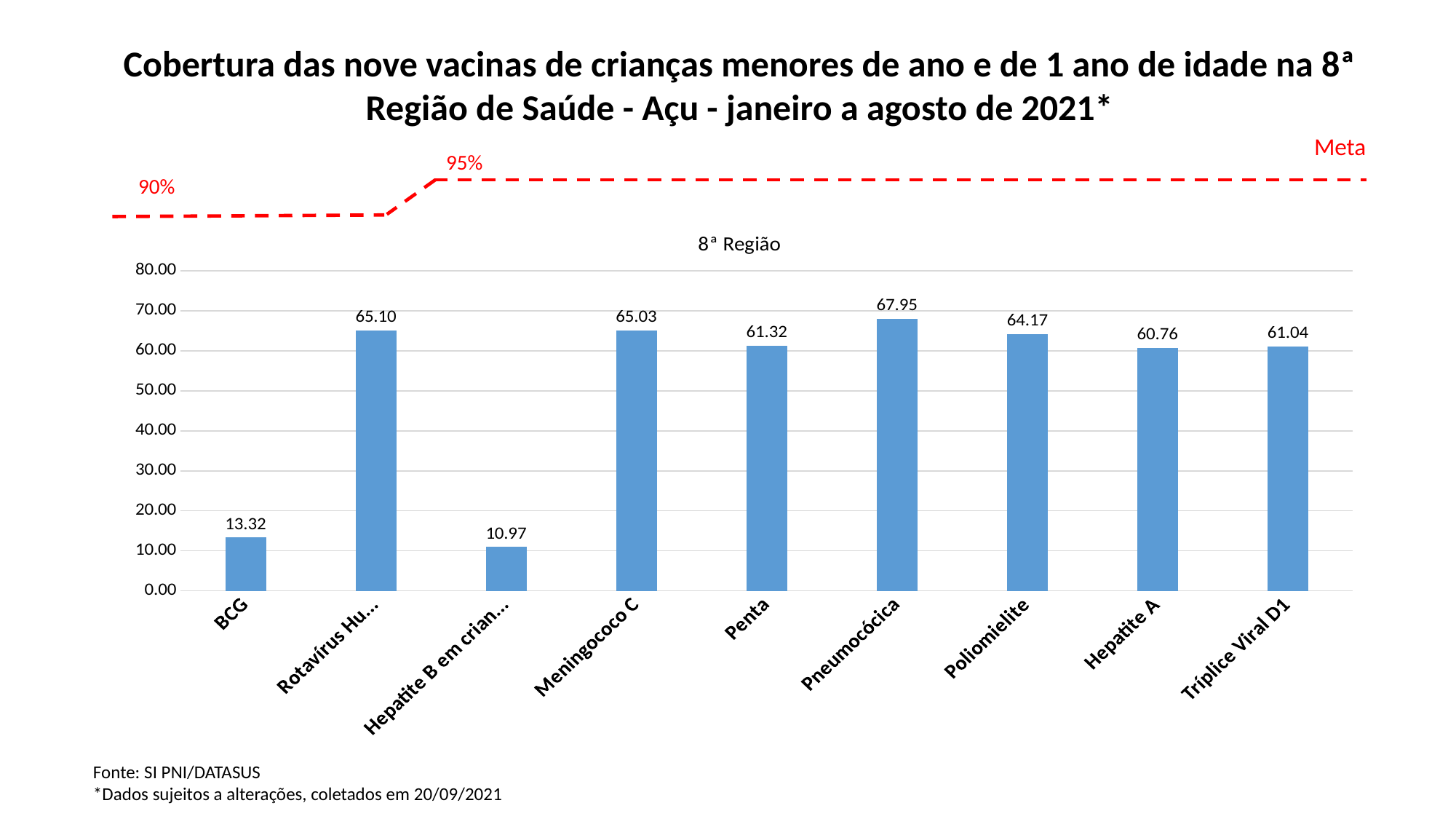
How many vaccines (bars) are shown on the chart? 9 What is the difference between the values for Pneumocócica and Poliomielite? 3.78 What kind of chart is shown on the slide? bar chart What is the lowest value shown on the chart? 10.97 What is the value for Pneumocócica? 67.95 What is the difference between the values for Tríplice Viral D1 and Hepatite A? 0.28 Is the value for Poliomielite greater or less than 60? greater What is the value for Penta? 61.32 What is the value for BCG? 13.32 What is the value for Tríplice Viral D1? 61.04 Which is larger, the value for Meningococo C or the value for Hepatite A? Meningococo C Which vaccine has the highest coverage value? Pneumocócica